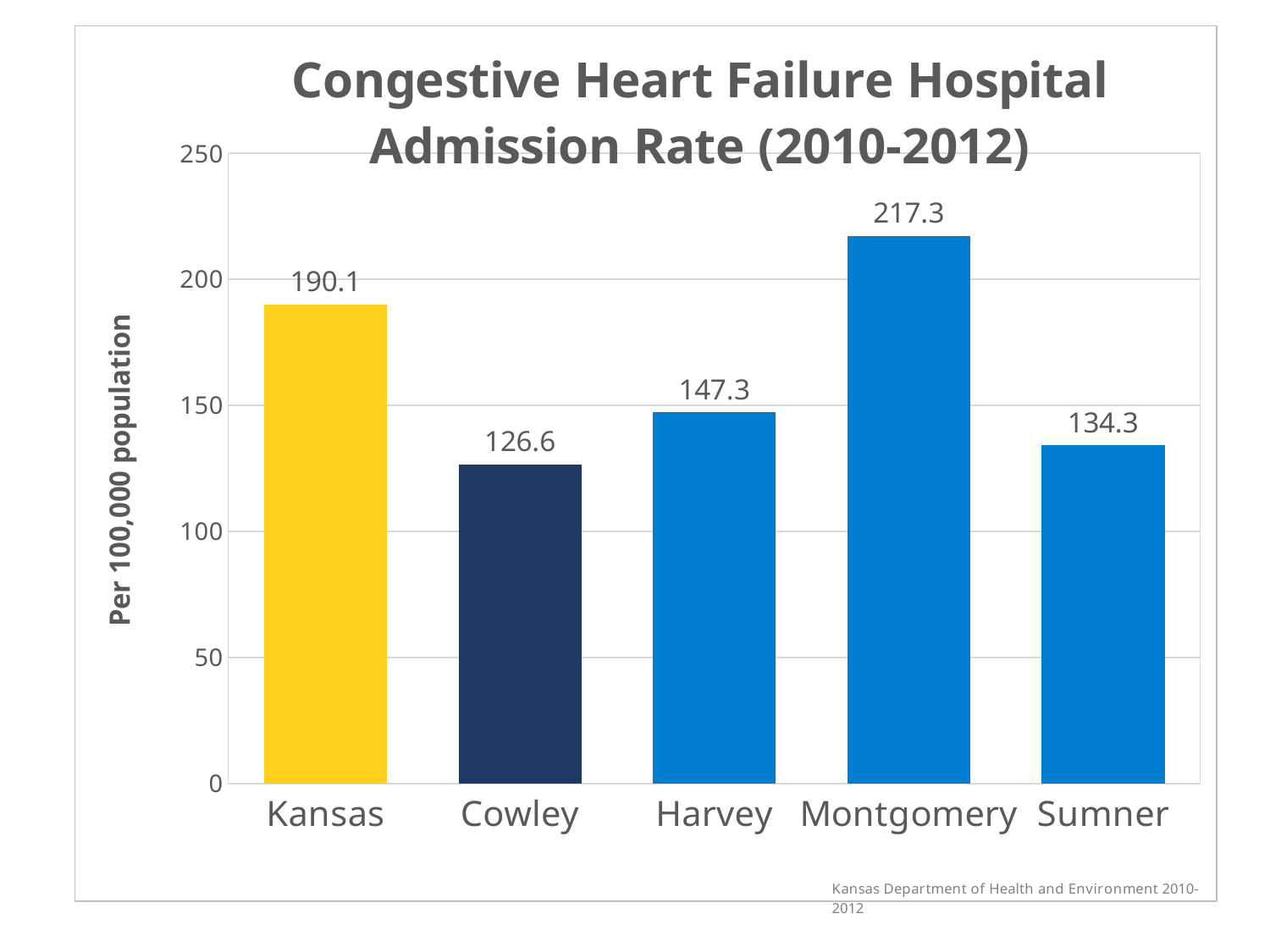
What is the congestive heart failure hospital admission rate for Sumner? 134.3 What is the congestive heart failure hospital admission rate for Montgomery? 217.3 Which category has the lowest congestive heart failure hospital admission rate? Cowley What is the difference between the admission rates for Harvey and Cowley? 20.7 Is the value for Cowley greater or less than 150? less Which category has the highest congestive heart failure hospital admission rate? Montgomery Which has a higher admission rate, Harvey or Sumner? Harvey What kind of chart is shown on the slide? Bar chart What is the congestive heart failure hospital admission rate for Kansas? 190.1 What is the congestive heart failure hospital admission rate for Cowley? 126.6 What is the difference between the admission rates for Montgomery and Kansas? 27.2 How many categories are shown on the x axis? 5